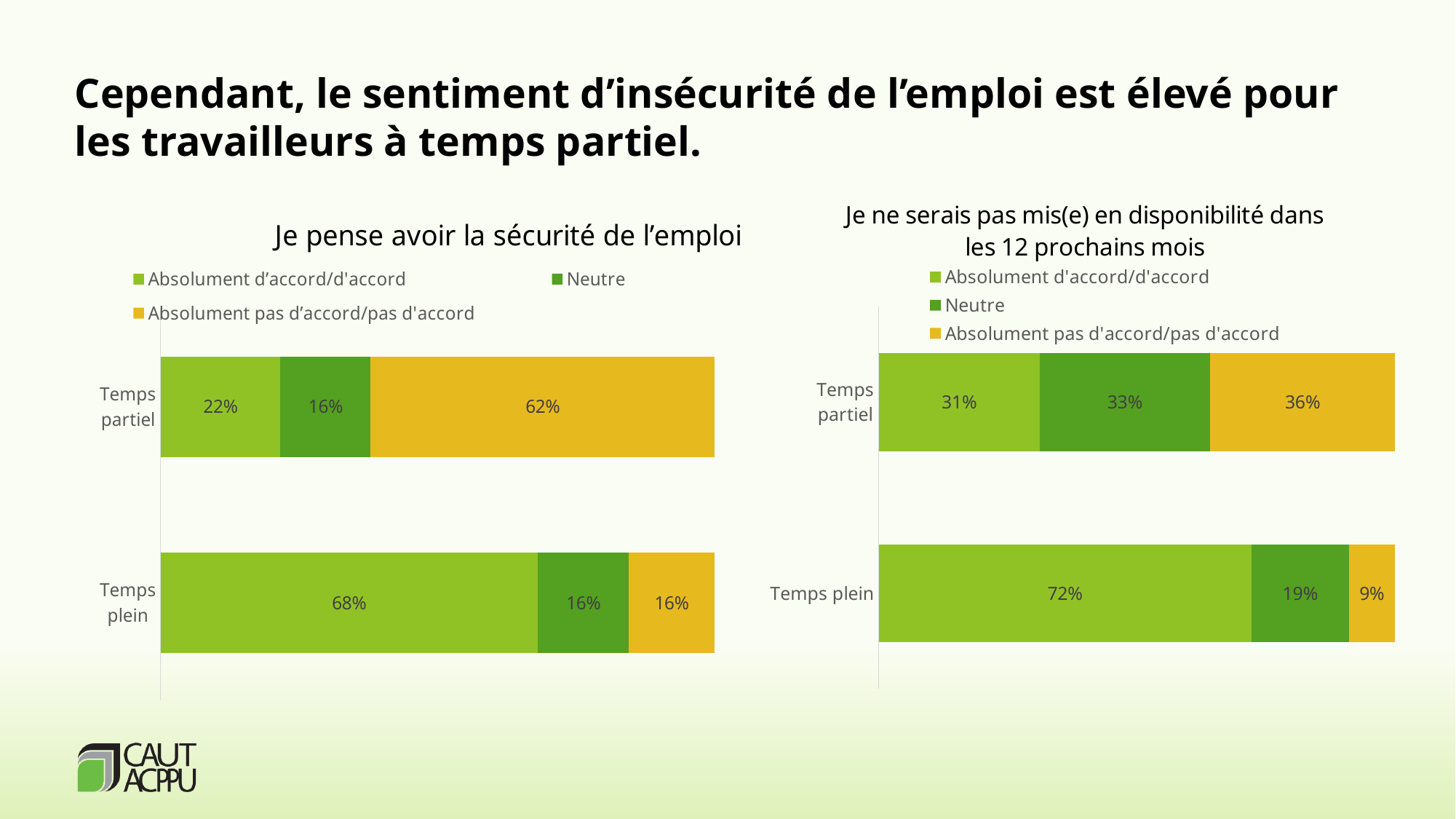
In the chart titled "Je pense avoir la sécurité de l'emploi", what is the value for "Absolument pas d'accord/pas d'accord" for Temps plein? 16% How many categories are shown in the chart titled "Je ne serais pas mis(e) en disponibilité dans les 12 prochains mois"? 2 How many series does the legend of the chart titled "Je pense avoir la sécurité de l'emploi" list? 3 In the chart titled "Je ne serais pas mis(e) en disponibilité dans les 12 prochains mois", which category has the higher "Absolument d'accord/d'accord" value? Temps plein What kind of chart is the chart titled "Je pense avoir la sécurité de l'emploi"? Stacked bar chart In the chart titled "Je pense avoir la sécurité de l'emploi", which category has the larger "Absolument pas d'accord/pas d'accord" value, Temps partiel or Temps plein? Temps partiel In the chart titled "Je pense avoir la sécurité de l'emploi", what is the difference between the "Absolument d'accord/d'accord" values for Temps plein and Temps partiel? 46% In the chart titled "Je ne serais pas mis(e) en disponibilité dans les 12 prochains mois", what is the difference between the "Absolument pas d'accord/pas d'accord" values for Temps partiel and Temps plein? 27% In the chart titled "Je ne serais pas mis(e) en disponibilité dans les 12 prochains mois", what is the value for "Neutre" for Temps partiel? 33% In the chart titled "Je pense avoir la sécurité de l'emploi", what is the value for "Absolument d'accord/d'accord" for Temps partiel? 22% In the chart titled "Je ne serais pas mis(e) en disponibilité dans les 12 prochains mois", what is the value for "Absolument d'accord/d'accord" for Temps plein? 72% In the chart titled "Je ne serais pas mis(e) en disponibilité dans les 12 prochains mois", what is the total of the Temps plein bar? 100%